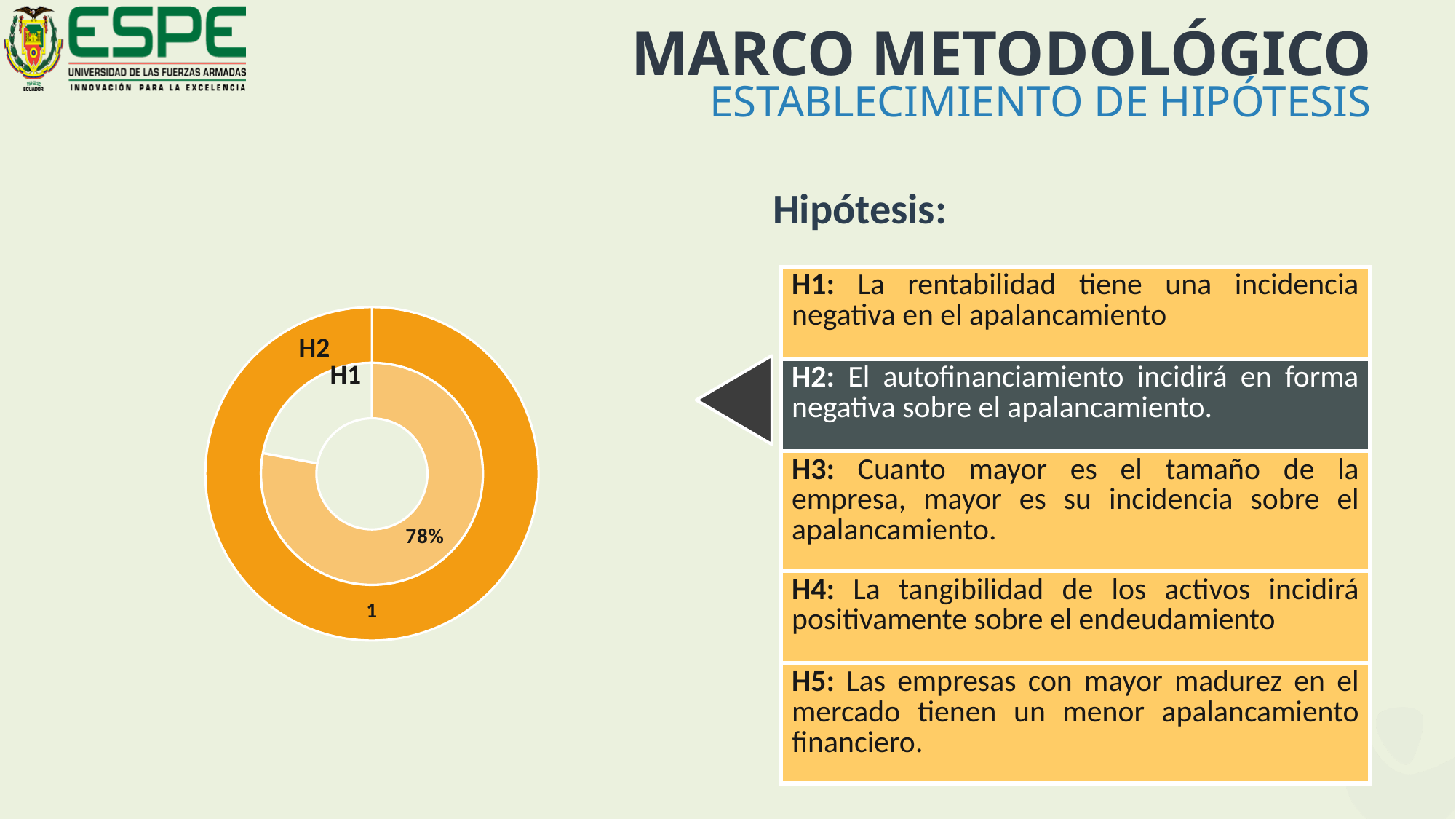
Is the percentage shown on the inner ring (H1) greater or less than 50%? greater What percentage is printed on the inner ring of the doughnut chart? 78% How many rings does the doughnut chart have? 2 What kind of chart is shown on the left of the slide? doughnut chart What value is printed on the outer ring of the doughnut chart? 1 Which label is attached to the inner ring of the doughnut chart? H1 Which label is attached to the outer ring of the doughnut chart? H2